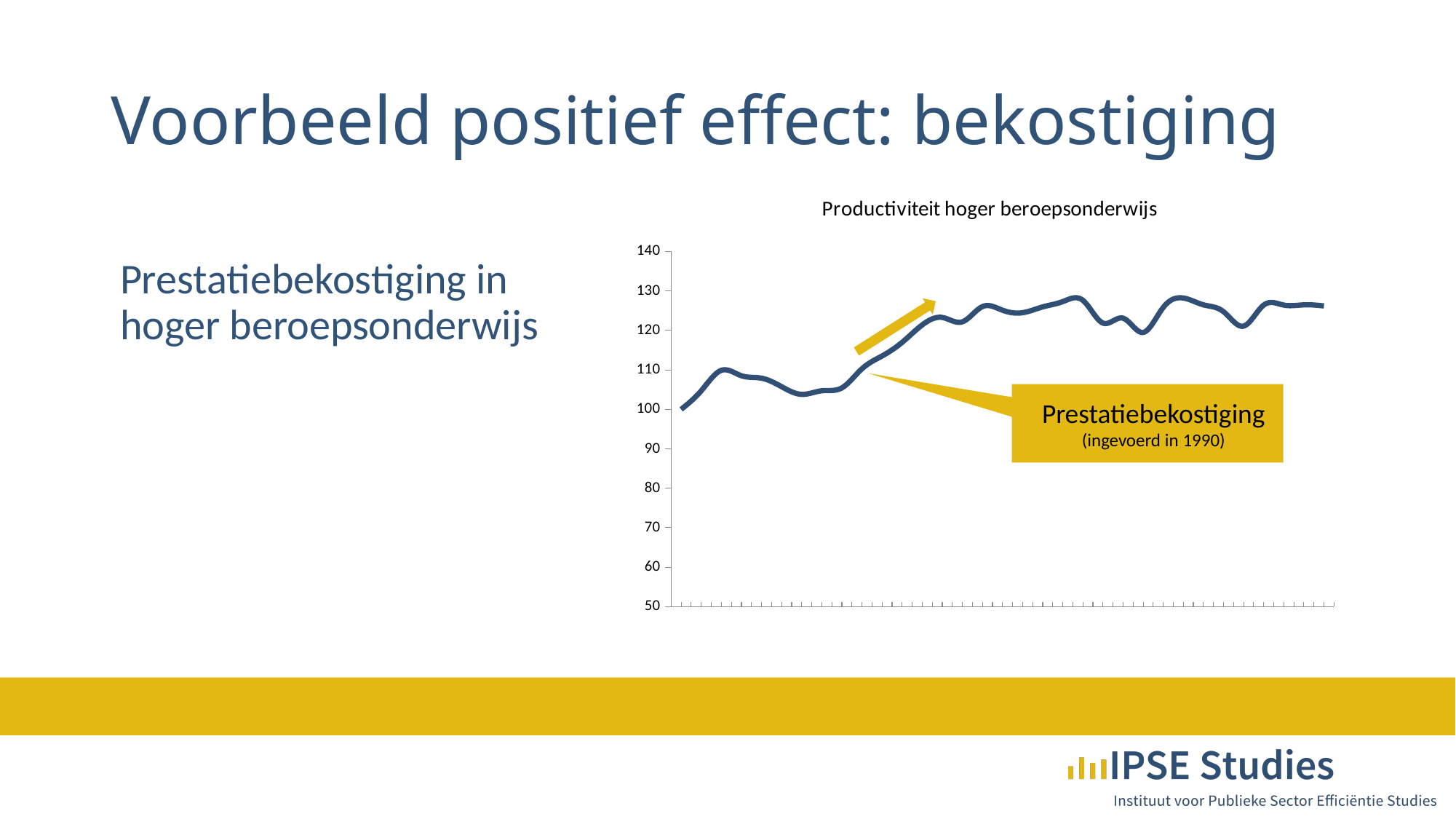
Is the value at the right end of the line higher or lower than the value at the left end? higher Is the value at the right end of the line greater or less than 120? greater What is the highest value shown on the vertical axis? 140 Is the highest point of the line greater or less than 130? less What is the title of the chart? Productiviteit hoger beroepsonderwijs Is the lowest point of the line greater or less than 90? greater Overall, does the productivity line rise or fall from left to right? rise What kind of chart is shown on the slide? line chart According to the annotation on the chart, in which year was Prestatiebekostiging introduced? 1990